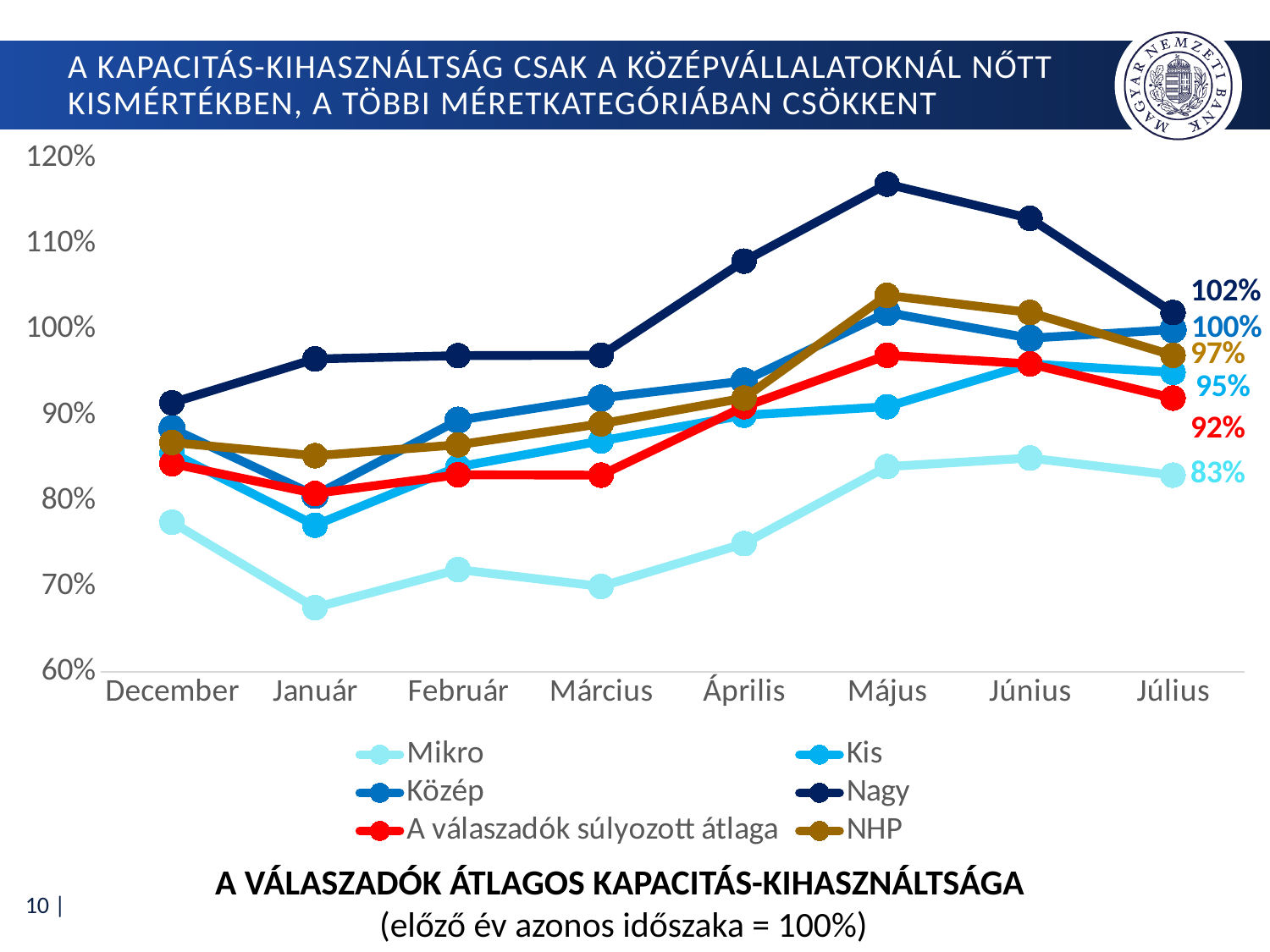
How many series does the legend list? 6 What is the value for NHP in Július? 97% Is the value for Mikro in Január greater or less than 70%? less Which series has the lowest value in Július? Mikro What is the value for Nagy in Július? 102% What kind of chart is shown on the slide? line chart What is the value for A válaszadók súlyozott átlaga in Július? 92% What is the difference between the Július values of Nagy and Mikro? 19% Is the value for Nagy in Május greater or less than 110%? greater Which series has the highest value in Július? Nagy How many months are shown on the x axis? 8 What is the value for Mikro in Július? 83%